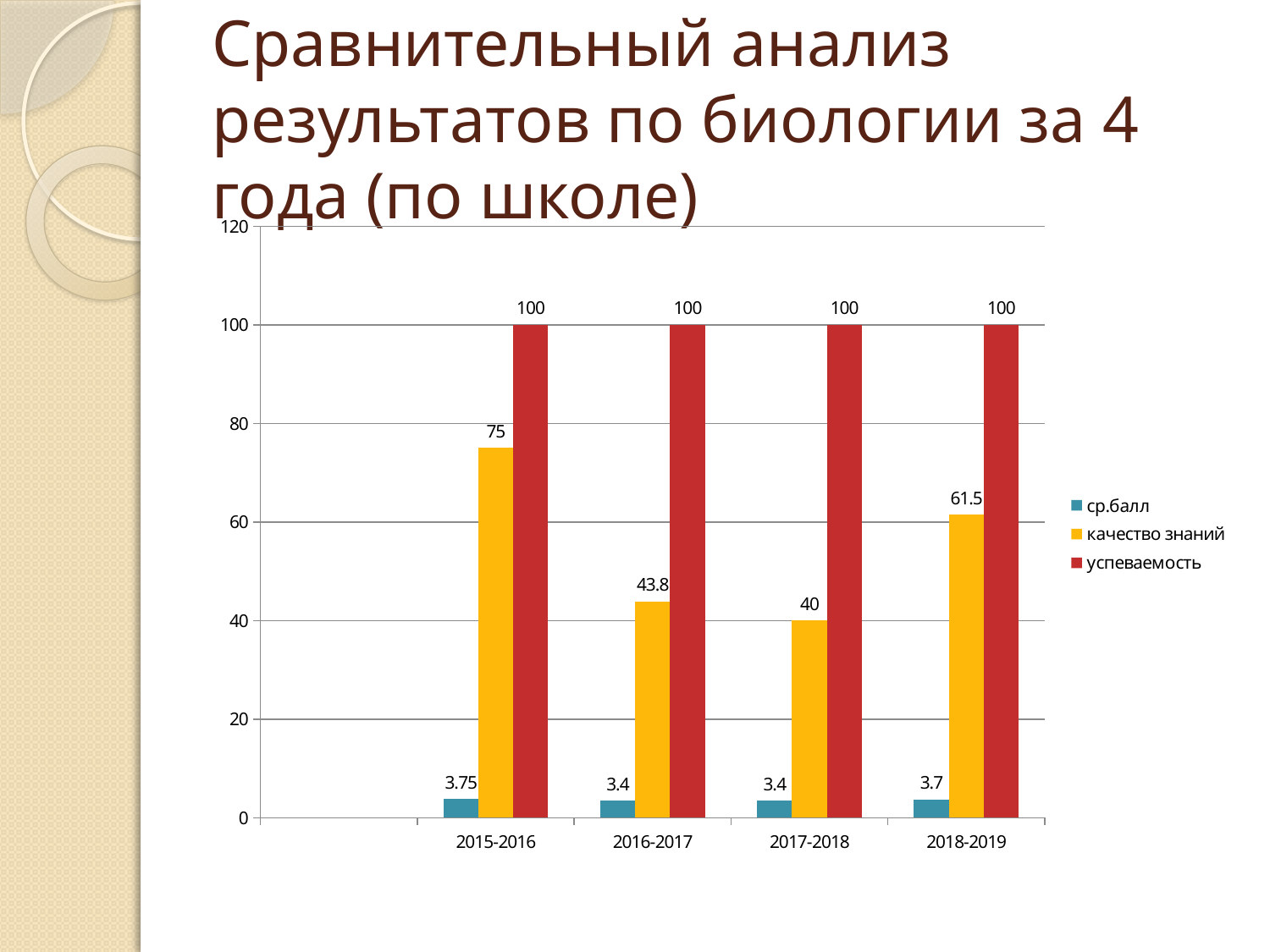
What kind of chart is shown on the slide? bar chart Is the value of качество знаний for 2018-2019 greater or less than 60? greater What is the difference between качество знаний in 2015-2016 and 2018-2019? 13.5 What is the value of ср.балл for 2018-2019? 3.7 Which is larger: качество знаний in 2016-2017 or in 2017-2018? 2016-2017 In which year is качество знаний the highest? 2015-2016 How many school years are shown on the x axis? 4 Which colour represents успеваемость in the legend? red In which year is качество знаний the lowest? 2017-2018 What is the value of успеваемость for 2017-2018? 100 What is the value of качество знаний for 2015-2016? 75 How many series does the legend list? 3